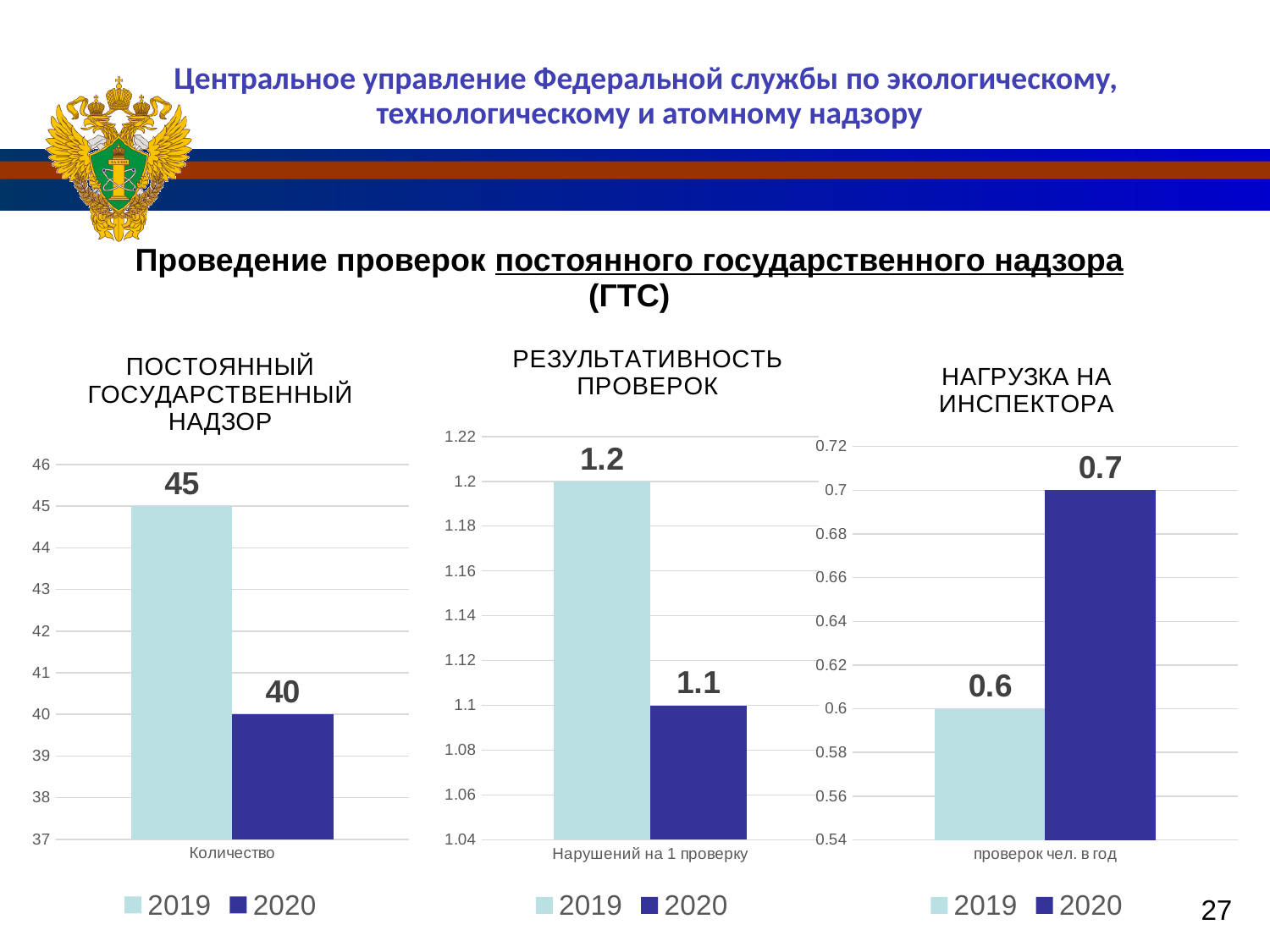
How many series does the legend of the chart titled 'ПОСТОЯННЫЙ ГОСУДАРСТВЕННЫЙ НАДЗОР' list? 2 In the chart titled 'НАГРУЗКА НА ИНСПЕКТОРА', which year has the higher value? 2020 In the chart titled 'НАГРУЗКА НА ИНСПЕКТОРА', does the value rise or fall from 2019 to 2020? rise In the chart titled 'НАГРУЗКА НА ИНСПЕКТОРА', what is the value for 2020? 0.7 In the chart titled 'РЕЗУЛЬТАТИВНОСТЬ ПРОВЕРОК', which year has the higher value? 2019 In the chart titled 'ПОСТОЯННЫЙ ГОСУДАРСТВЕННЫЙ НАДЗОР', what is the value for 2020? 40 In the chart titled 'РЕЗУЛЬТАТИВНОСТЬ ПРОВЕРОК', what is the value for 2019? 1.2 In the chart titled 'ПОСТОЯННЫЙ ГОСУДАРСТВЕННЫЙ НАДЗОР', what is the difference between the 2019 and 2020 values? 5 What kind of chart is the chart titled 'РЕЗУЛЬТАТИВНОСТЬ ПРОВЕРОК'? bar chart In the chart titled 'НАГРУЗКА НА ИНСПЕКТОРА', what is the value for 2019? 0.6 In the chart titled 'РЕЗУЛЬТАТИВНОСТЬ ПРОВЕРОК', what is the value for 2020? 1.1 In the chart titled 'ПОСТОЯННЫЙ ГОСУДАРСТВЕННЫЙ НАДЗОР', what is the value for 2019? 45